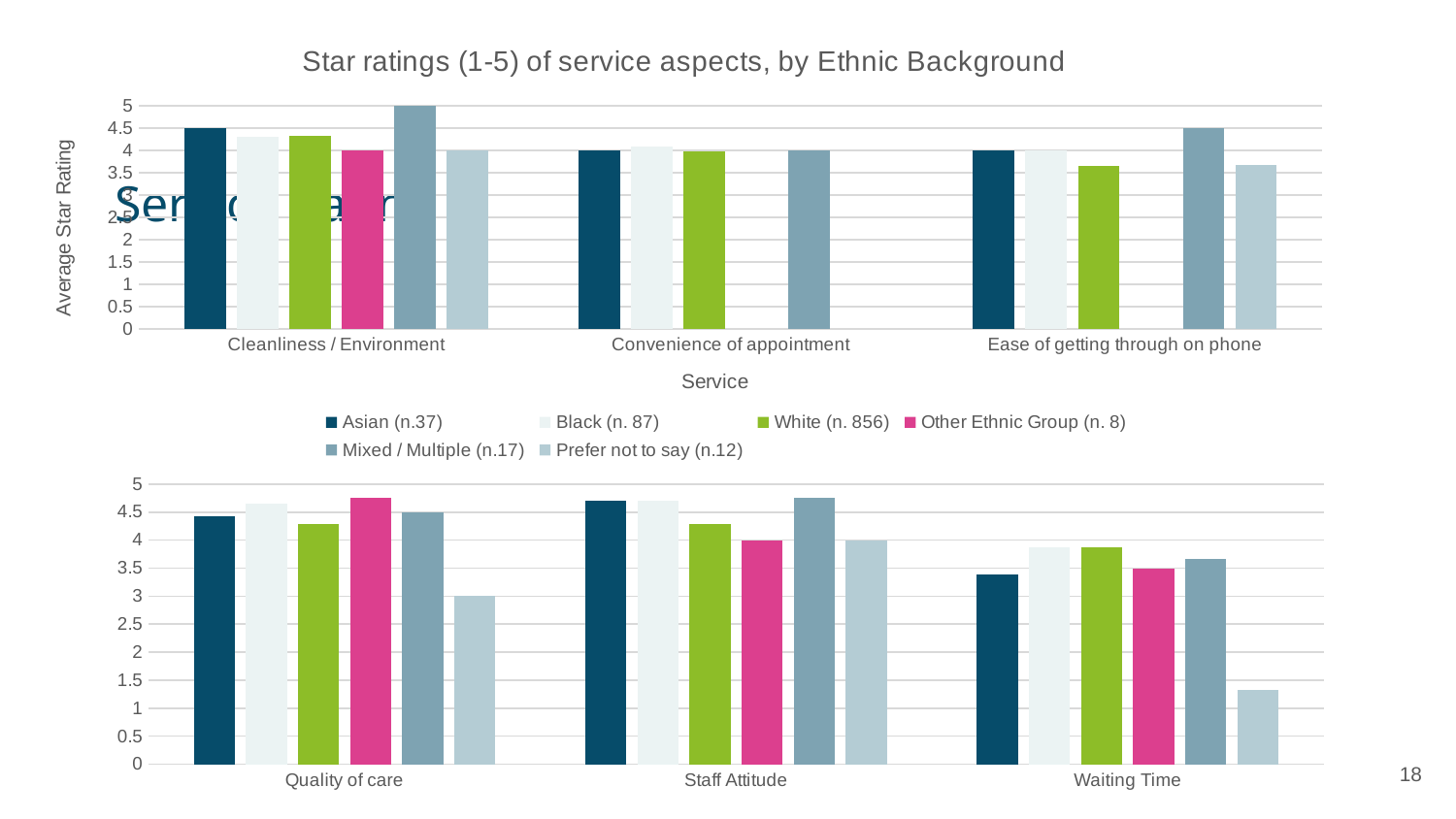
In the bottom chart, which ethnic group has the lowest rating for Quality of care? Prefer not to say (n.12) In the top chart, is the Ease of getting through on phone rating for Mixed / Multiple (n.17) greater or less than 4? greater In the bottom chart, is the Waiting Time rating for Prefer not to say (n.12) greater or less than 1.5? less What is the title of the top chart? Star ratings (1-5) of service aspects, by Ethnic Background How many series does the legend list? 6 In the bottom chart, how many service categories are shown on the x axis? 3 In the bottom chart, which ethnic group has the lowest rating for Waiting Time? Prefer not to say (n.12) In the top chart, how many service categories are shown on the x axis? 3 In the top chart, for Cleanliness / Environment, which is rated higher: Asian (n.37) or Other Ethnic Group (n. 8)? Asian (n.37) In the top chart, which ethnic group has the highest rating for Cleanliness / Environment? Mixed / Multiple (n.17) In the top chart, what kind of chart is used to show the star ratings? Bar chart In the top chart, which ethnic group has the highest rating for Ease of getting through on phone? Mixed / Multiple (n.17)